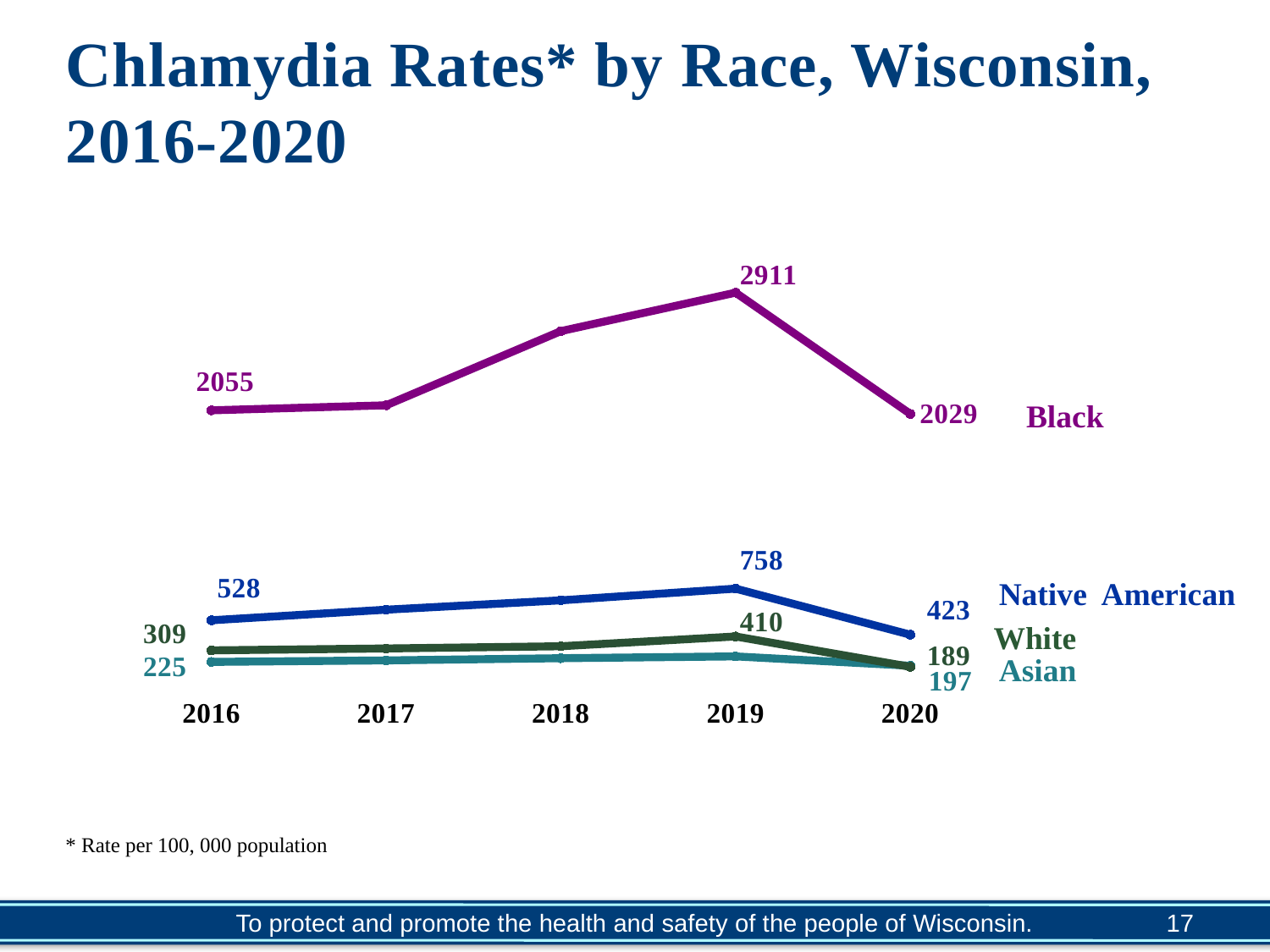
What was the chlamydia rate for the Asian population in 2016? 225 How many race groups are plotted on the chart? 4 What type of chart is shown on the slide? Line chart Which race had the lowest chlamydia rate in 2016? Asian What was the chlamydia rate for the Black population in 2019? 2911 What was the chlamydia rate for the Black population in 2016? 2055 How many years are shown on the x axis? 5 Which race had the highest chlamydia rate in 2019? Black What was the chlamydia rate for the Native American population in 2020? 423 How much higher was the Black rate in 2019 than in 2016? 856 Which was larger in 2016, the Native American rate or the White rate? Native American What was the chlamydia rate for the White population in 2019? 410